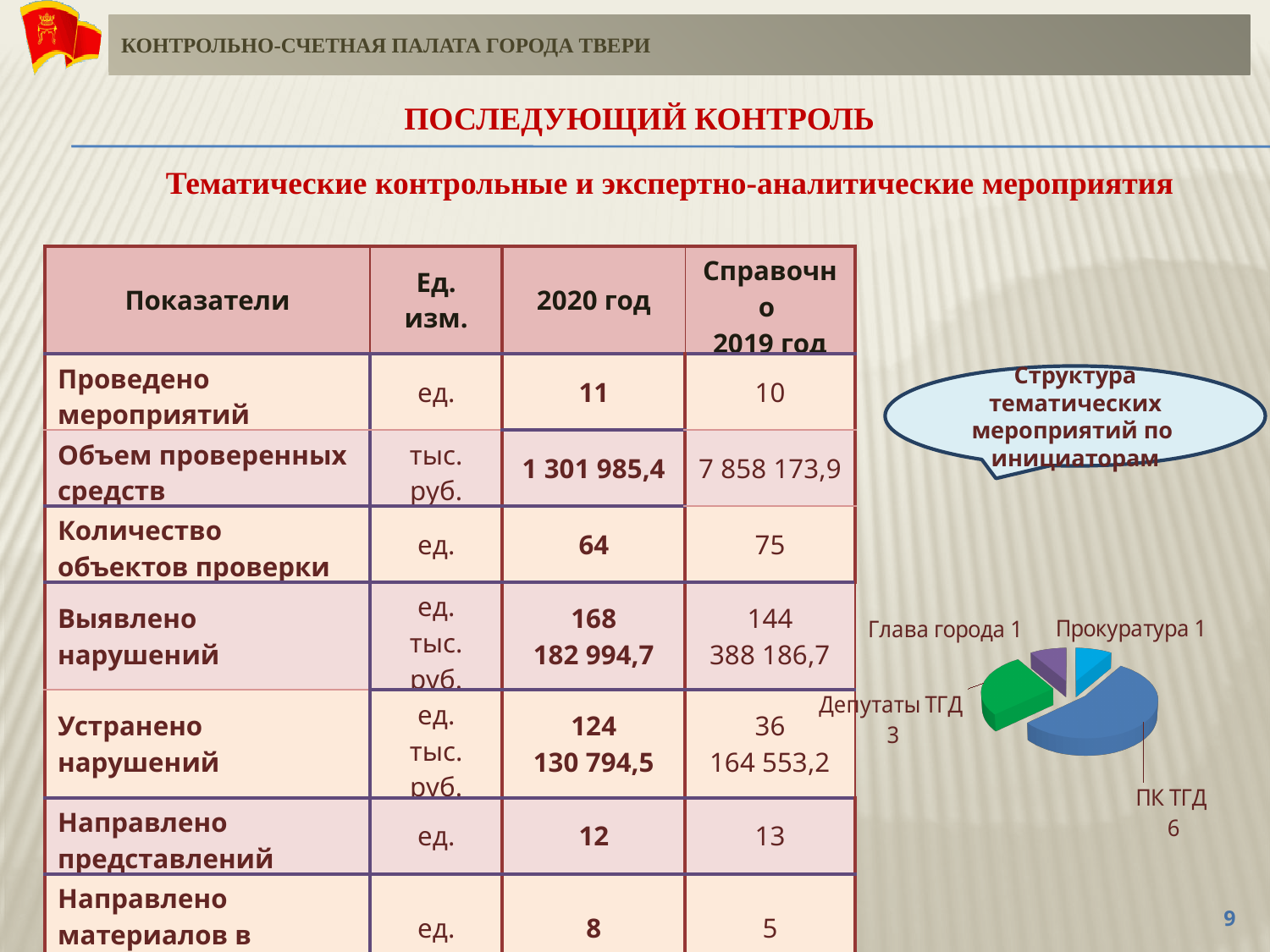
What is the total of all slices in the pie chart? 11 What colour is the ПК ТГД slice in the pie chart? blue Which category has the largest slice in the pie chart? ПК ТГД What is the title of the pie chart? Структура тематических мероприятий по инициаторам What is the difference between the values for ПК ТГД and Депутаты ТГД in the pie chart? 3 What kind of chart is shown on the slide? pie chart How many slices does the pie chart have? 4 Which is larger in the pie chart, Депутаты ТГД or Прокуратура? Депутаты ТГД What is the value for ПК ТГД in the pie chart? 6 What is the value for Прокуратура in the pie chart? 1 What is the value for Депутаты ТГД in the pie chart? 3 What is the value for Глава города in the pie chart? 1